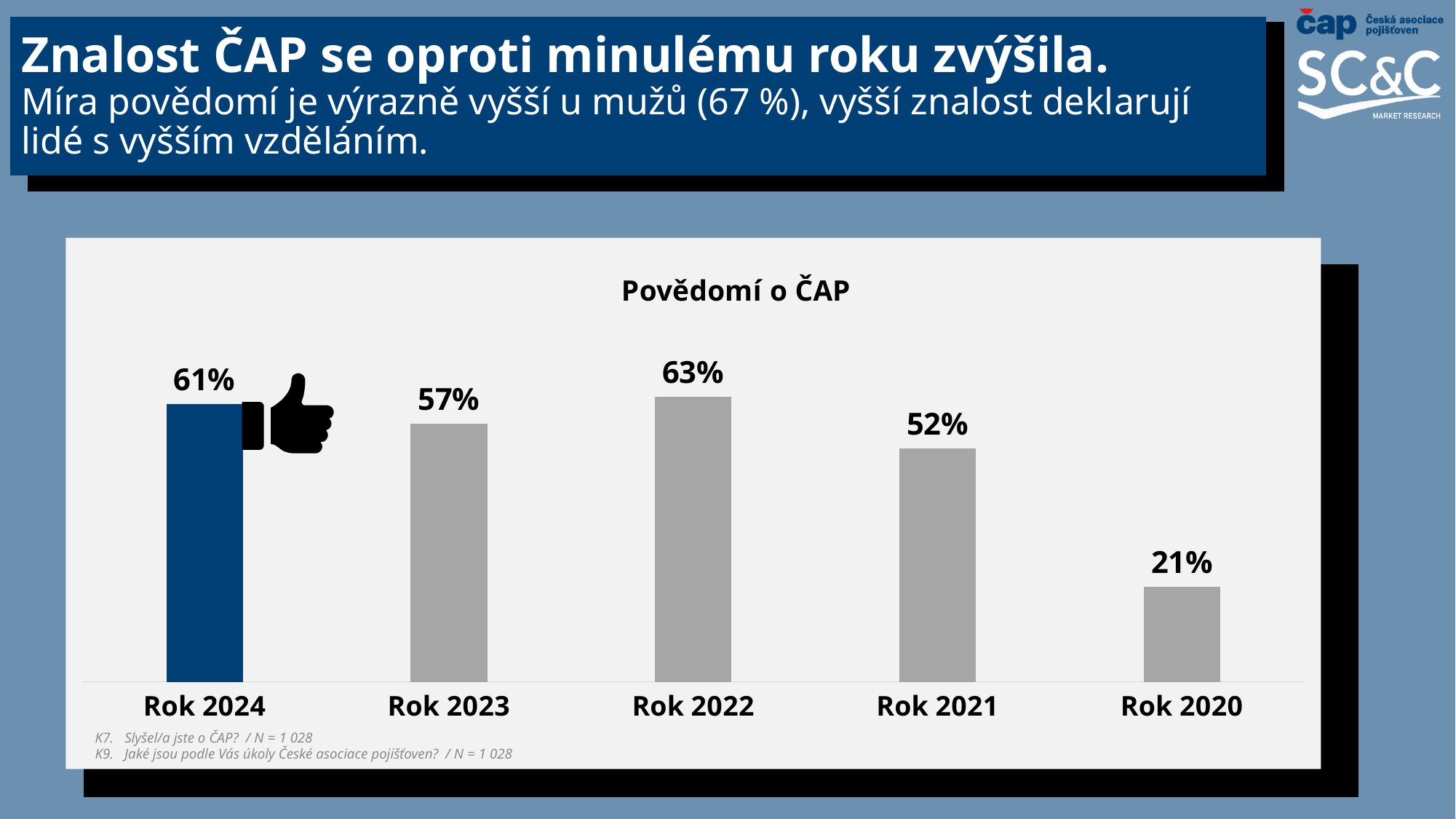
What is the value for Rok 2020? 21% What is the value for Rok 2024? 61% What is the difference between the values for Rok 2021 and Rok 2020? 31% What is the value for Rok 2022? 63% What kind of chart is this? bar chart What is the title of the chart? Povědomí o ČAP Which year has the lowest value? Rok 2020 Which is larger, the value for Rok 2023 or the value for Rok 2021? Rok 2023 What is the difference between the values for Rok 2024 and Rok 2023? 4% Which bar is coloured dark blue rather than grey? Rok 2024 How many years are shown in the chart? 5 Which year has the highest value? Rok 2022